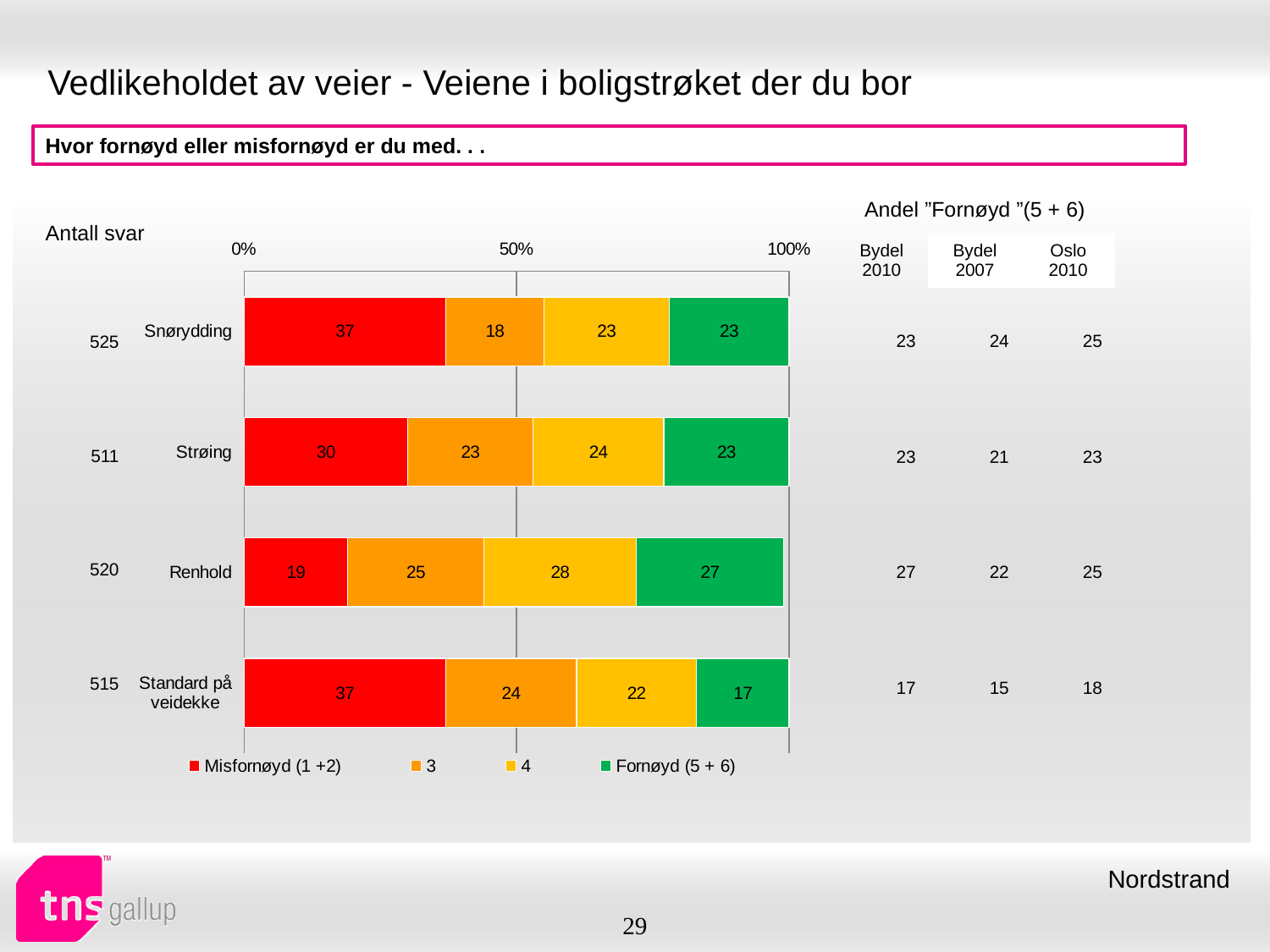
What is the value of the Fornøyd (5 + 6) segment for Renhold? 27 Which category has the highest Fornøyd (5 + 6) value? Renhold Which colour represents the Fornøyd (5 + 6) series in the legend? green How many categories are plotted in the bar chart? 4 What is the value of the '4' segment for Standard på veidekke? 22 Which is larger: the Fornøyd (5 + 6) value for Strøing or for Standard på veidekke? Strøing What type of chart is shown on the slide? stacked bar chart How many series does the legend of the bar chart list? 4 What is the difference between the Misfornøyd (1 +2) values for Snørydding and Strøing? 7 Which category has the lowest Misfornøyd (1 +2) value? Renhold What is the total of the stacked bar for Strøing? 100 What is the value of the Misfornøyd (1 +2) segment for Snørydding? 37